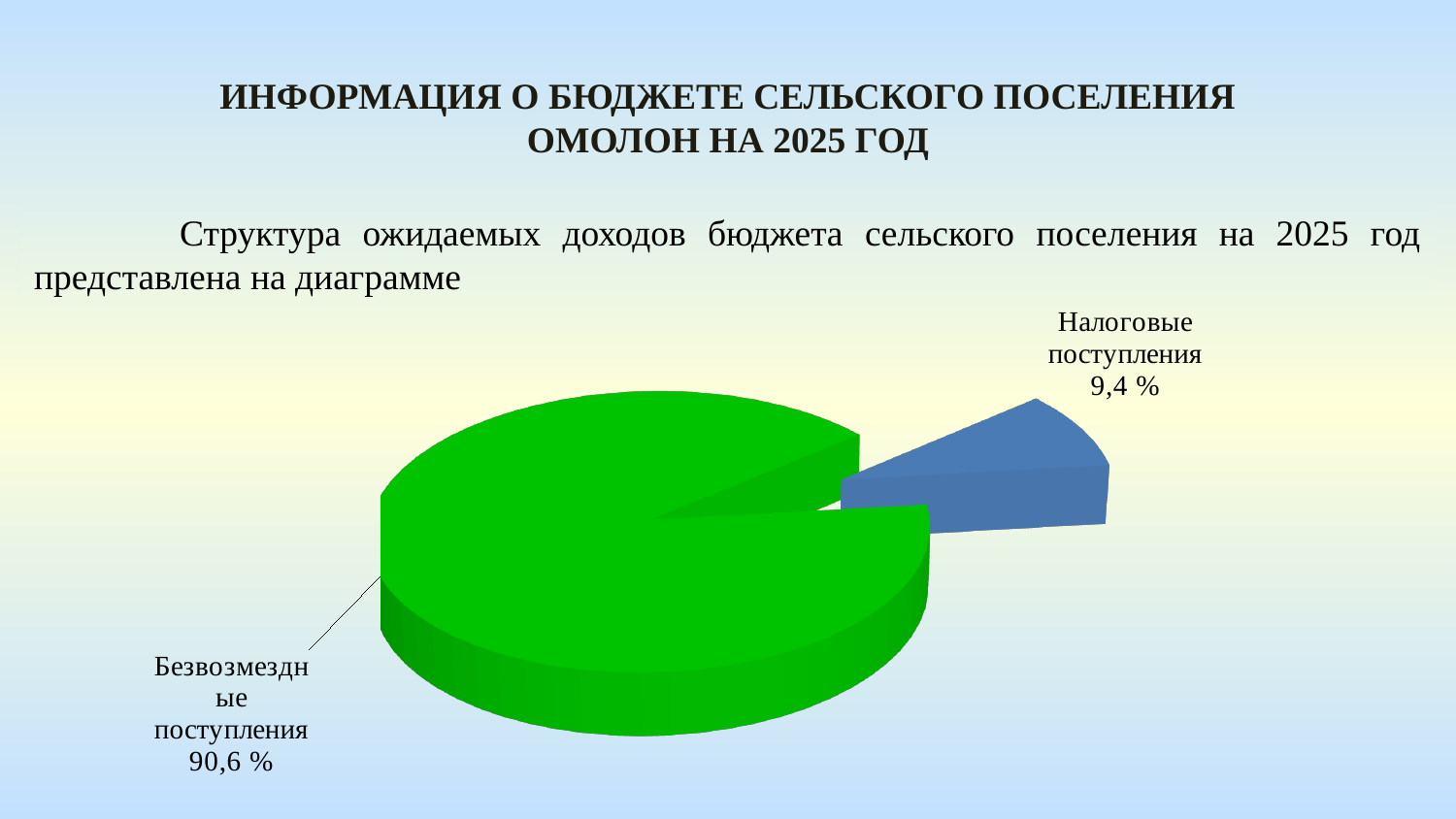
Which category has the largest slice in the pie chart? Безвозмездные поступления Which is larger in the pie chart: Налоговые поступления or Безвозмездные поступления? Безвозмездные поступления What share of the pie chart is labelled for Налоговые поступления? 9,4 % What kind of chart is shown on the slide? Pie chart Which category has the smallest slice in the pie chart? Налоговые поступления What colour is the slice for Налоговые поступления? Blue What is the difference in percentage points between Безвозмездные поступления and Налоговые поступления? 81,2 % What colour is the slice for Безвозмездные поступления? Green How many slices does the pie chart have? 2 What is the total of the two percentages shown on the pie chart? 100 % What share of the pie chart is labelled for Безвозмездные поступления? 90,6 %